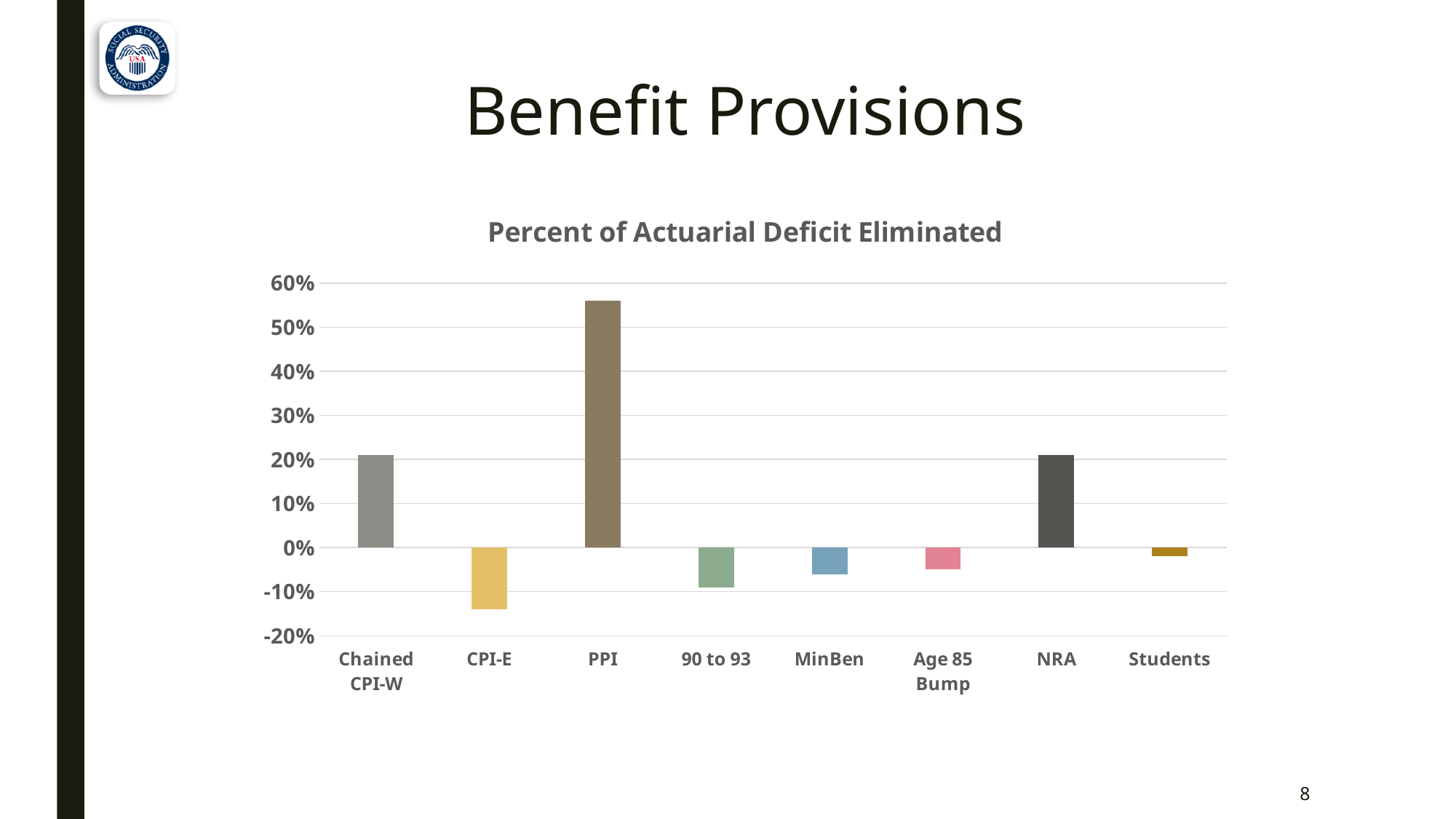
Which is larger, the value for Students or the value for CPI-E? Students Is the value for 90 to 93 greater or less than 0%? less Which is larger, the value for PPI or the value for NRA? PPI Which provision has the lowest (most negative) value on the chart? CPI-E Is the value for PPI greater or less than 50%? greater Is the value for CPI-E greater or less than -10%? less How many benefit provisions (categories) are plotted on the chart? 8 Which provision eliminates the highest percent of the actuarial deficit? PPI What kind of chart is shown on the slide? bar chart What is the title of the chart? Percent of Actuarial Deficit Eliminated